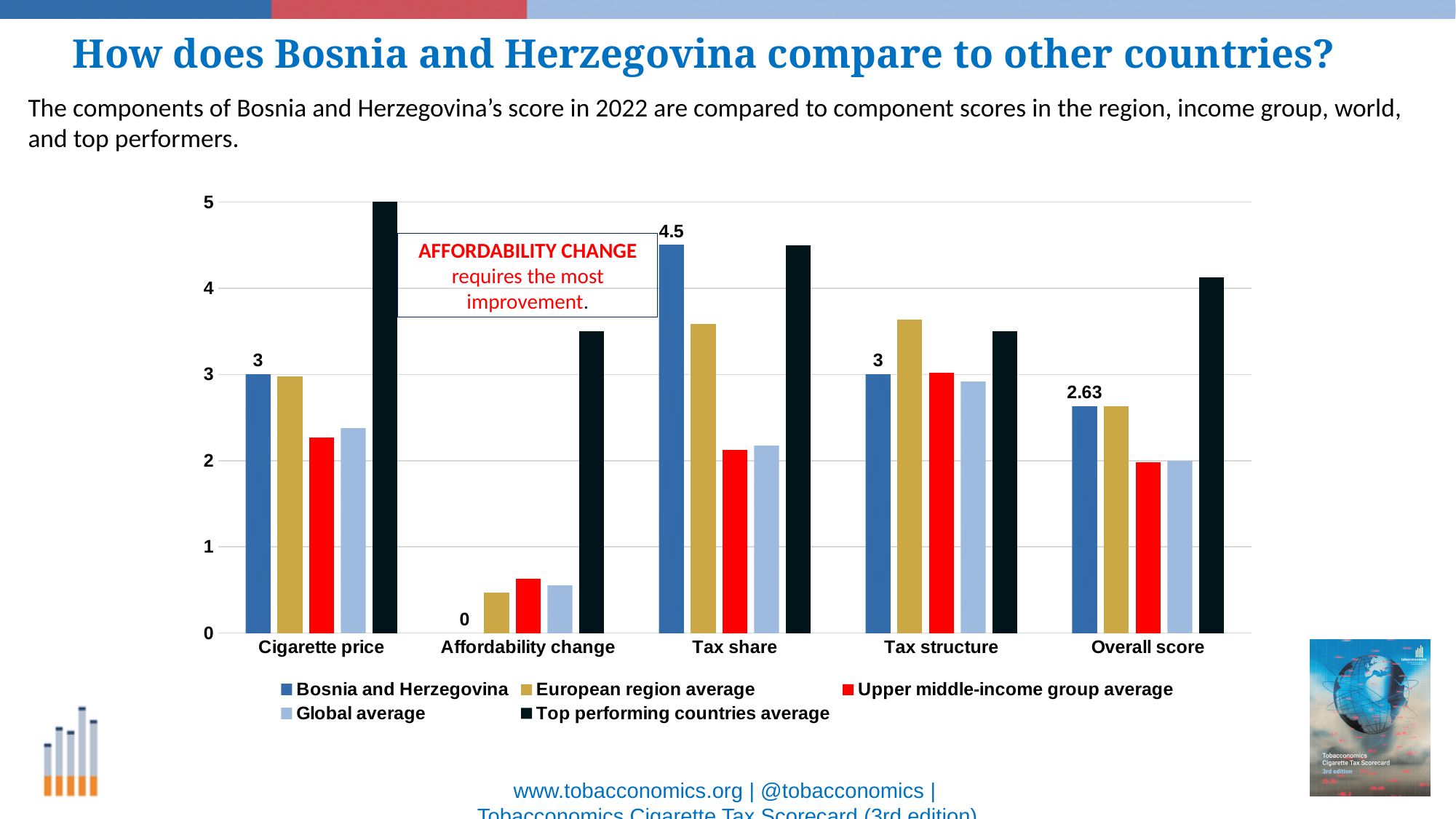
What is the Top performing countries average for Cigarette price? 5 How many series does the chart's legend list? 5 In which category does Bosnia and Herzegovina have its highest value? Tax share What is the value for Bosnia and Herzegovina in the Affordability change category? 0 In which category does Bosnia and Herzegovina have its lowest value? Affordability change Is the Upper middle-income group average for Tax share greater or less than 3? less What is Bosnia and Herzegovina's Overall score? 2.63 What is the value for Bosnia and Herzegovina in the Tax share category? 4.5 Is the Top performing countries average for Affordability change greater or less than 3? greater For Tax structure, which is larger: the Bosnia and Herzegovina value or the European region average? European region average How many categories are shown on the x axis of the chart? 5 What is the difference between Bosnia and Herzegovina's Tax share value and its Overall score? 1.87